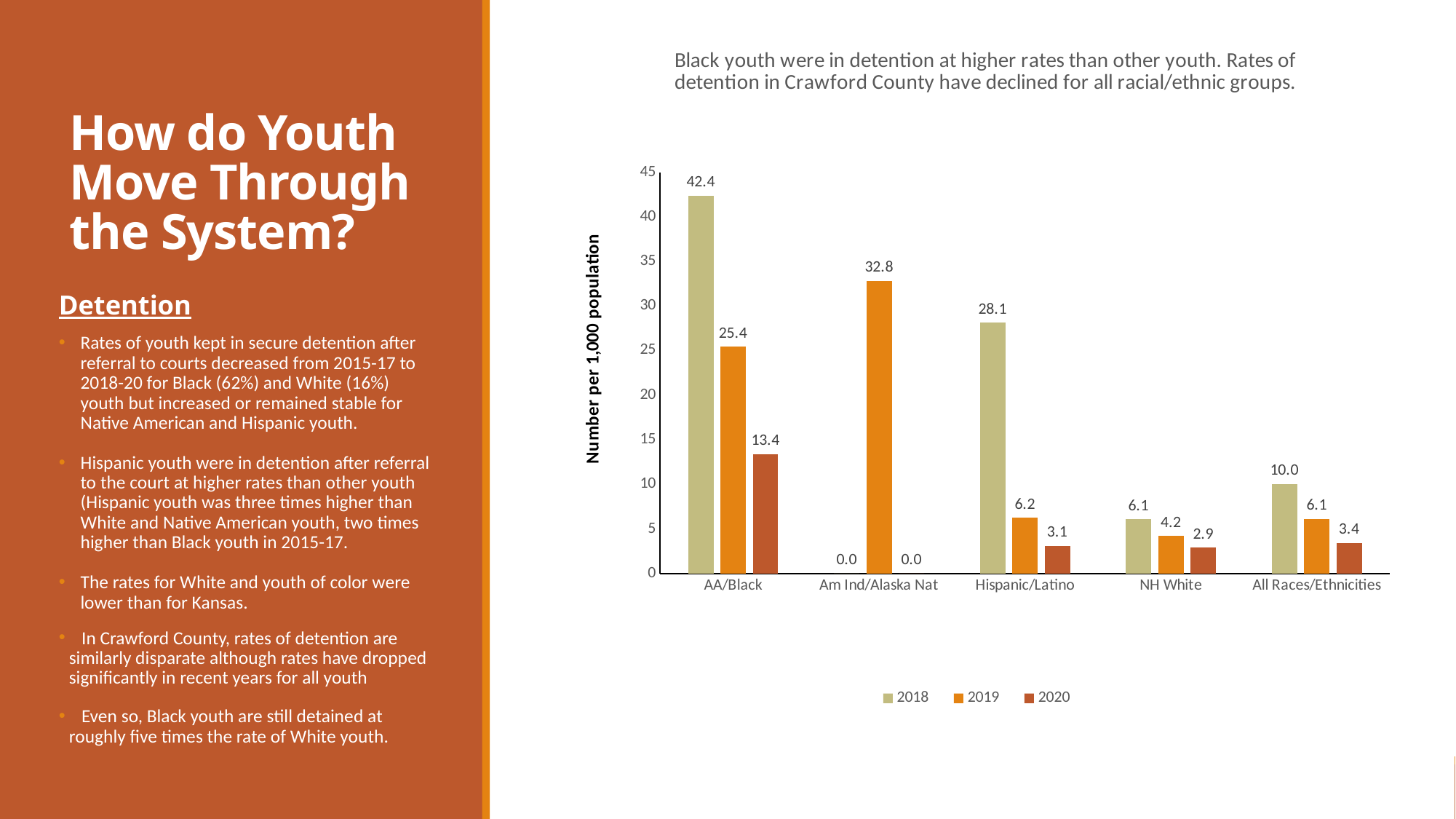
What is the difference between the 2018 and 2020 values for AA/Black? 29.0 What is the 2020 value for Hispanic/Latino? 3.1 What is the 2019 value for Am Ind/Alaska Nat? 32.8 Which is larger, the 2020 value for AA/Black or the 2020 value for All Races/Ethnicities? AA/Black What is the y-axis label of the chart? Number per 1,000 population What is the 2019 value for NH White? 4.2 What is the 2018 detention rate for AA/Black youth? 42.4 What kind of chart is shown? Bar chart How many categories are shown on the x axis? 5 Which category has the highest 2018 value? AA/Black How many series does the legend list? 3 Which category has the lowest 2019 value? NH White